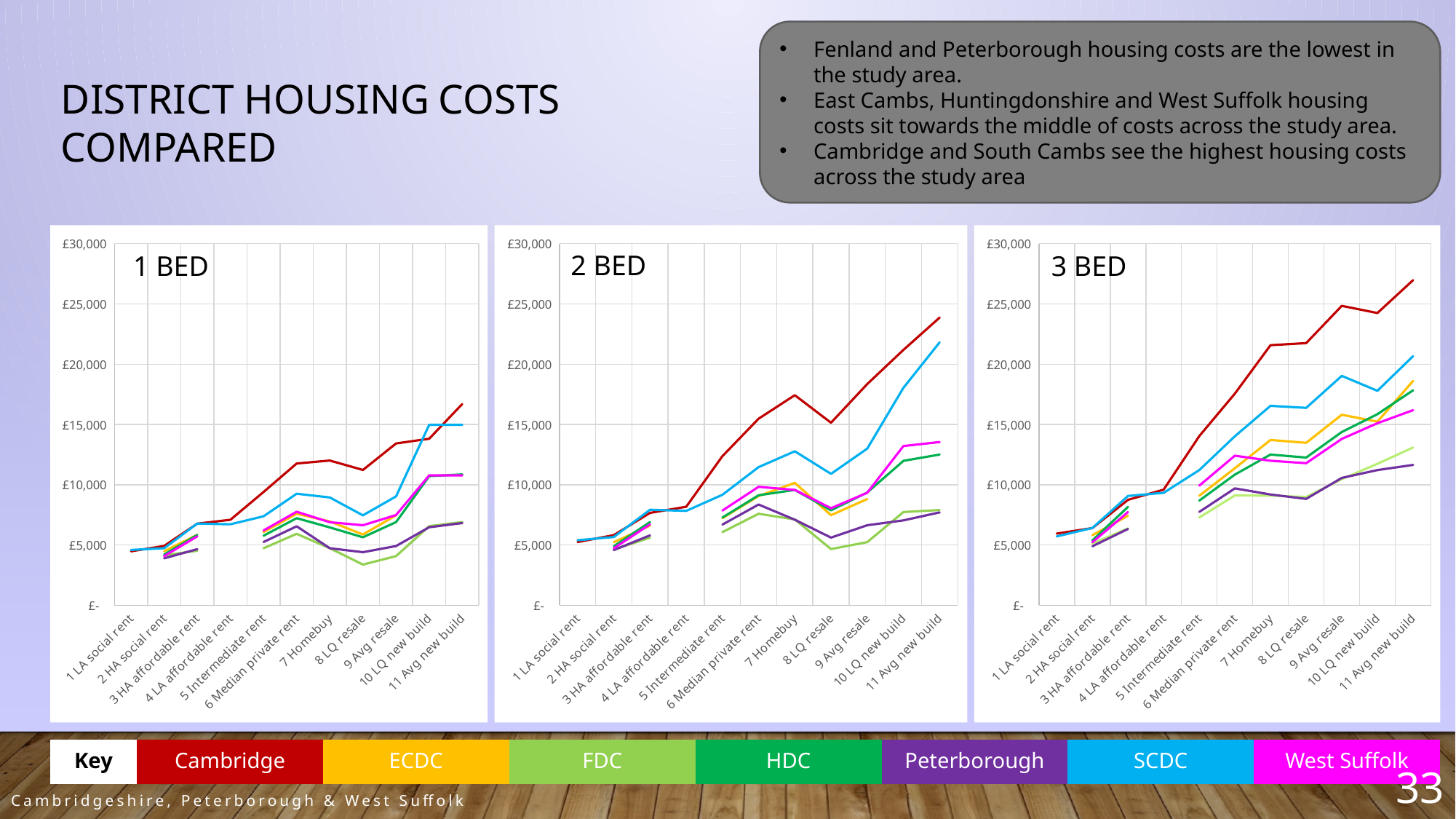
On the 3 BED chart, is the value for Cambridge at 7 Homebuy greater or less than £20,000? greater On the 1 BED chart, is the value for Cambridge at 11 Avg new build greater or less than £15,000? greater On the 3 BED chart, which is larger at 11 Avg new build: Cambridge or SCDC? Cambridge How many categories are shown on the x axis of the 1 BED chart? 11 On the 3 BED chart, which district has the highest value at 11 Avg new build? Cambridge What colour represents Cambridge in the key at the bottom of the slide? red On the 3 BED chart, does the Cambridge line rise or fall overall from 1 LA social rent to 11 Avg new build? rise On the 3 BED chart, is the value for Peterborough at 11 Avg new build greater or less than £15,000? less How many districts does the key at the bottom of the slide list? 7 What kind of chart is the 1 BED chart? line chart On the 1 BED chart, which district has the lowest value at 8 LQ resale? FDC